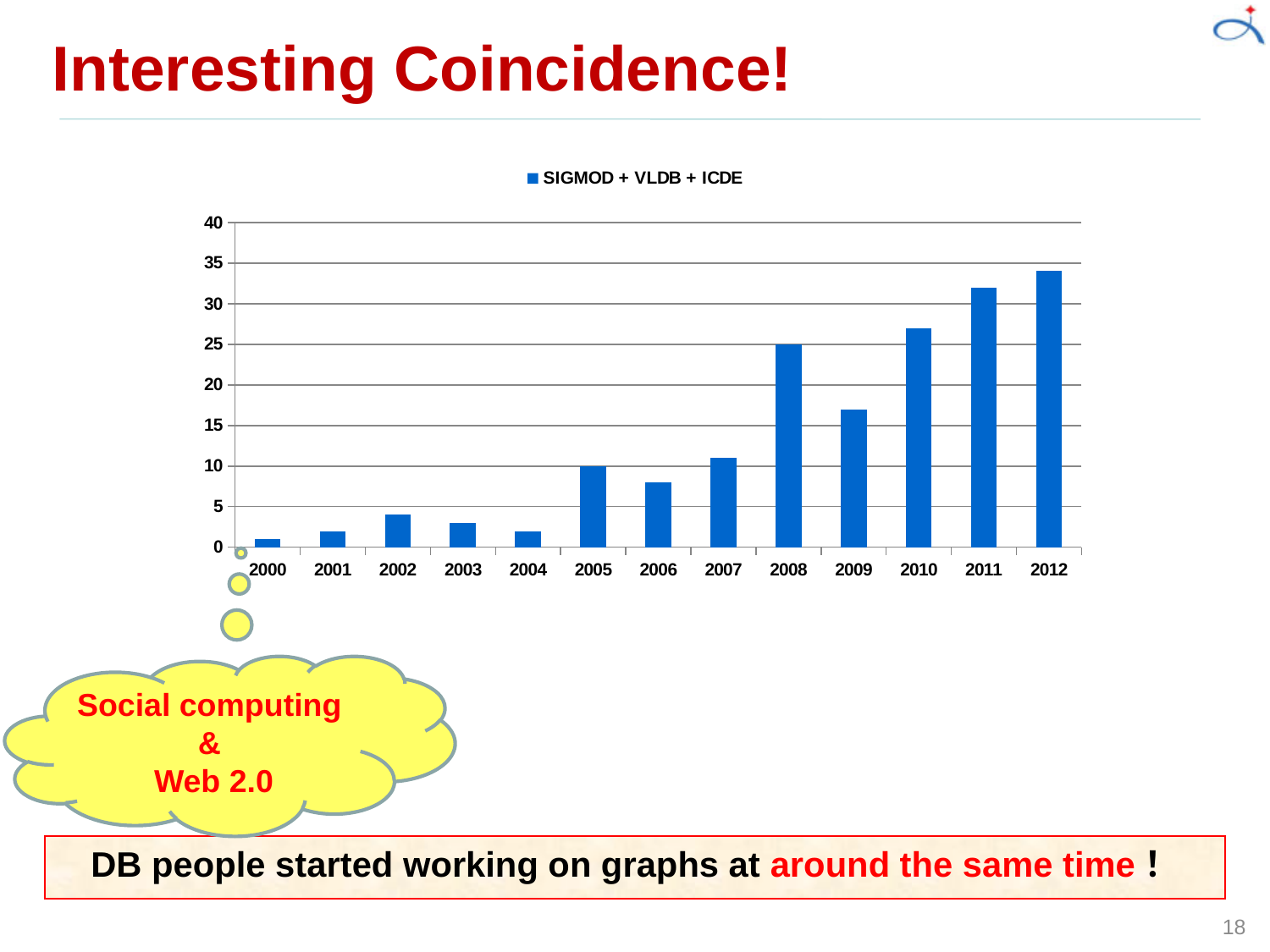
What kind of chart is shown on the slide? bar chart Which year has the lowest value? 2000 What is the value for 2008? 25 Do the values generally rise or fall from 2000 to 2012? rise Which is larger, the value for 2011 or the value for 2009? 2011 How many years are shown on the x axis? 13 Is the value for 2012 greater or less than 30? greater How many series does the legend list? 1 Is the value for 2006 greater or less than 10? less What is the name of the series shown in the legend? SIGMOD + VLDB + ICDE What is the value for 2005? 10 Which year has the highest value? 2012